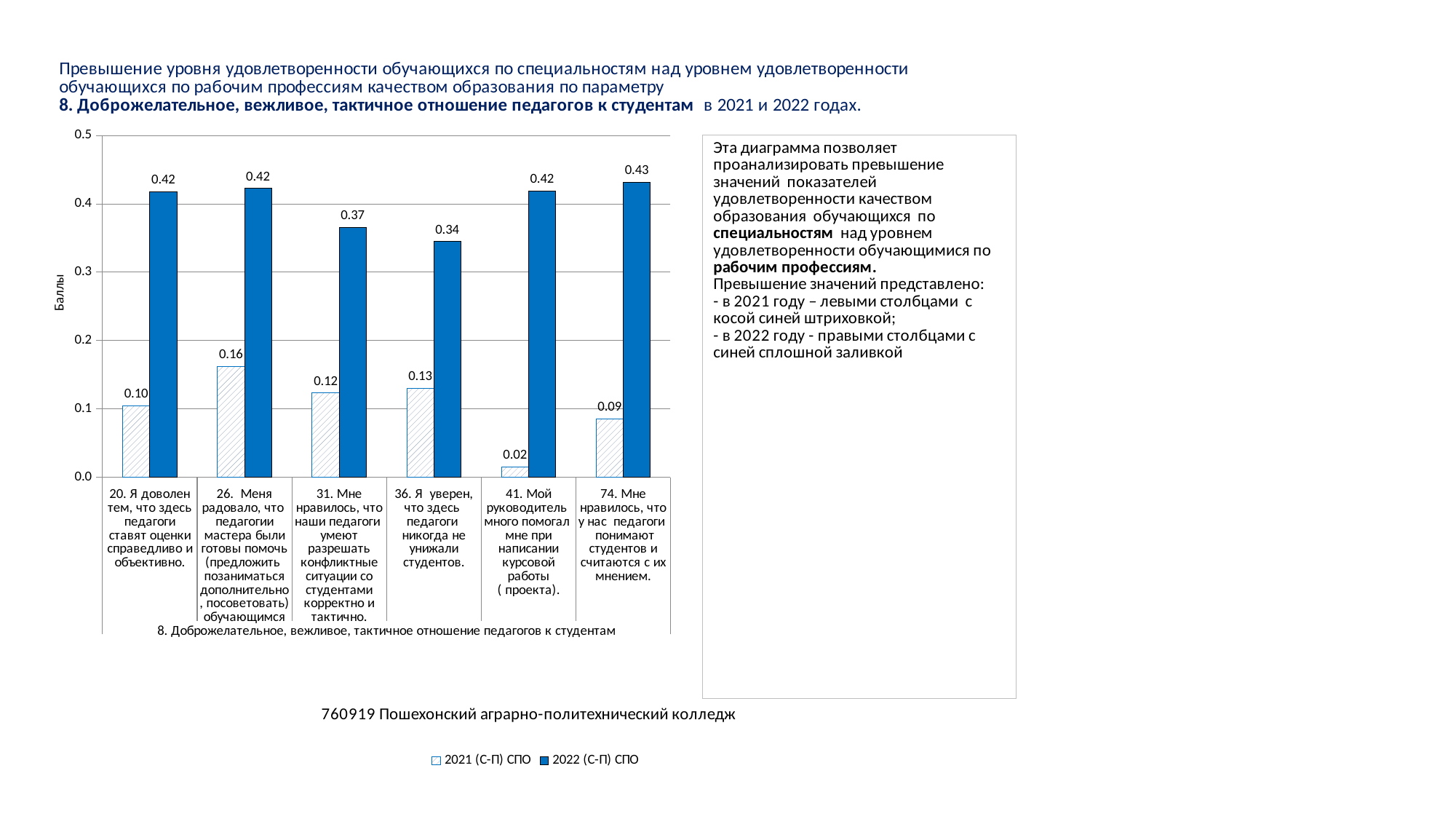
What is the difference between the 2022 and 2021 values for category 41? 0.40 How many series does the chart legend list? 2 Which category has the lowest 2022 (С-П) СПО value? 36. Я уверен, что здесь педагоги никогда не унижали студентов. What is the 2022 (С-П) СПО value for category 36 (Я уверен, что здесь педагоги никогда не унижали студентов)? 0.34 For category 20, which series has the larger value, 2021 (С-П) СПО or 2022 (С-П) СПО? 2022 (С-П) СПО What is the 2022 (С-П) СПО value for category 41 (Мой руководитель много помогал мне при написании курсовой работы)? 0.42 Which category has the lowest 2021 (С-П) СПО value? 41. Мой руководитель много помогал мне при написании курсовой работы (проекта). How many categories are shown on the x axis of the chart? 6 Which category has the highest 2021 (С-П) СПО value? 26. Меня радовало, что педагогии мастера были готовы помочь Is the 2022 (С-П) СПО value for category 31 greater or less than 0.3? greater What kind of chart is shown on the slide? bar chart What is the 2021 (С-П) СПО value for category 26 (Меня радовало, что педагогии мастера были готовы помочь)? 0.16